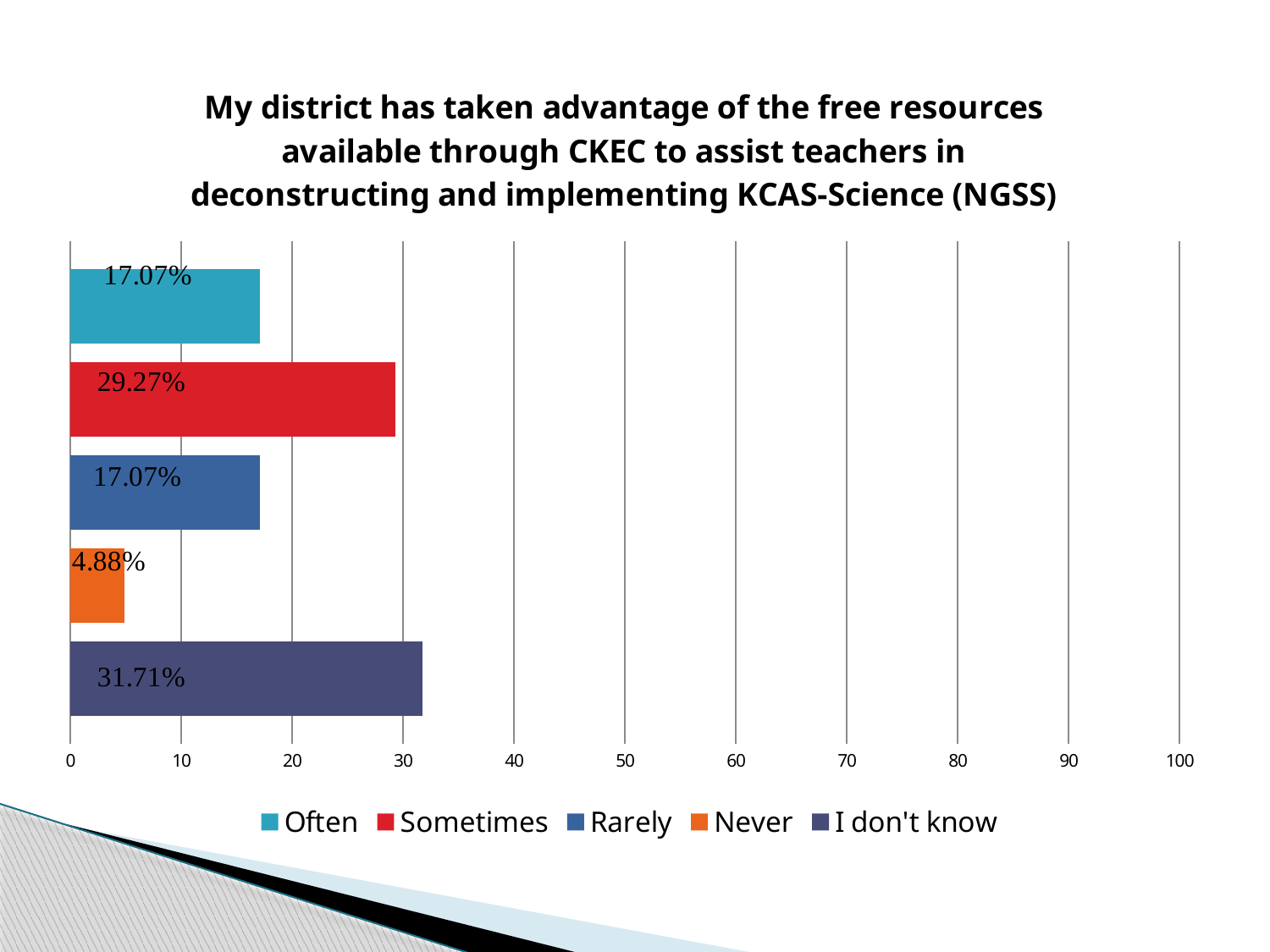
How many series does the legend list? 5 What is the value for Never? 4.88% What is the value for Sometimes? 29.27% What is the value for I don't know? 31.71% What kind of chart is shown on the slide? Bar chart Which is larger, the value for Sometimes or the value for Rarely? Sometimes What is the difference between the values for Sometimes and Never? 24.39% What is the difference between the values for I don't know and Sometimes? 2.44% Which response has the lowest value? Never Which response has the highest value? I don't know What is the value for Often? 17.07% Is the value for I don't know greater or less than 30? greater